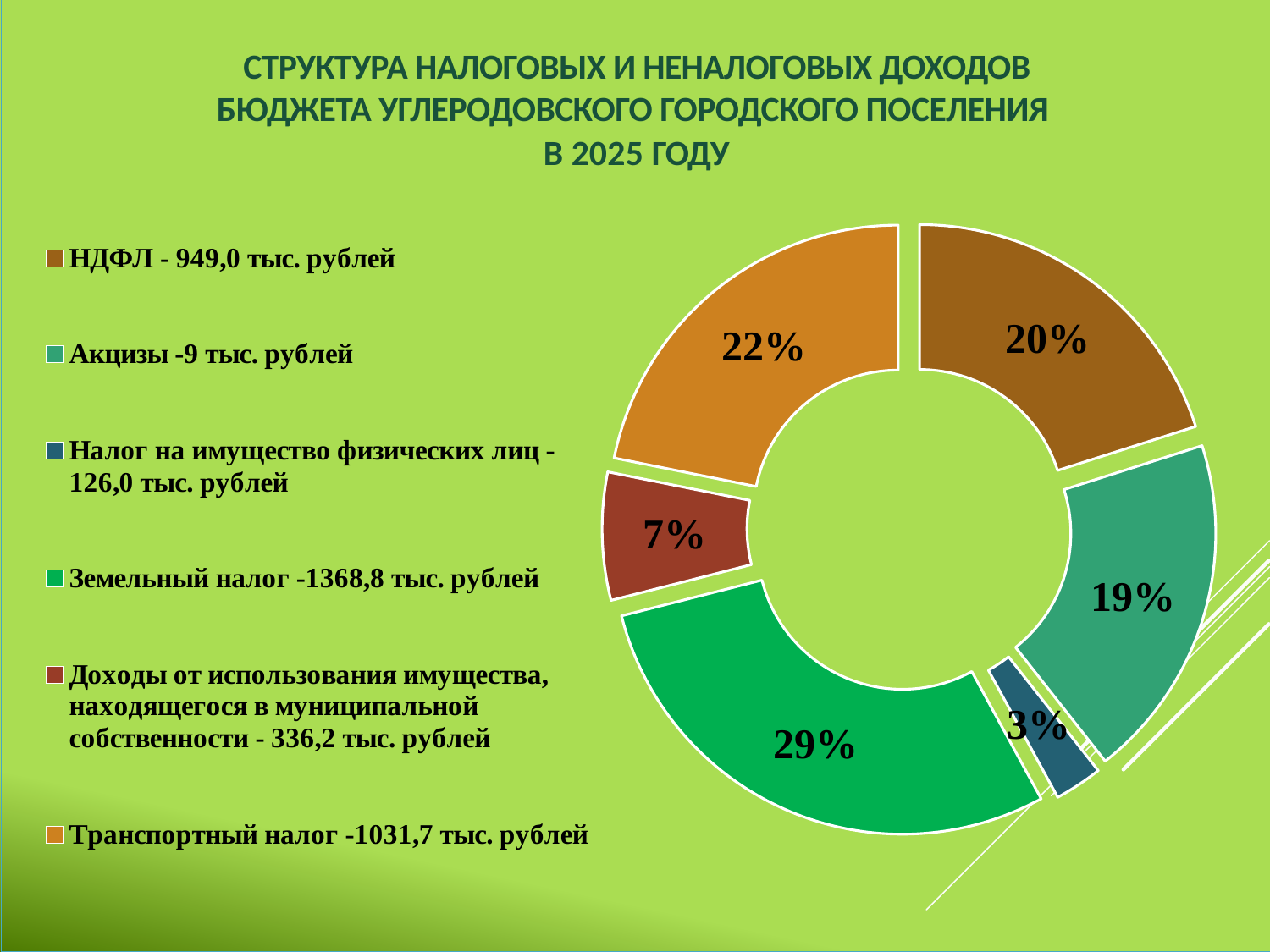
What percentage is shown for Транспортный налог? 22% What is the difference in percentage points between the Земельный налог share and the Транспортный налог share? 7% What percentage is shown for Налог на имущество физических лиц? 3% What share of the chart does Земельный налог account for? 29% What percentage is shown for Доходы от использования имущества, находящегося в муниципальной собственности? 7% Which category has the smallest share of the chart? Налог на имущество физических лиц Which category has the largest share of the chart? Земельный налог How many categories are shown in the chart? 6 What percentage is shown for НДФЛ? 20% What kind of chart is shown on the slide? Doughnut (pie) chart What amount does the legend give for Земельный налог? 1368,8 тыс. рублей Which has a larger share, НДФЛ or Транспортный налог? Транспортный налог